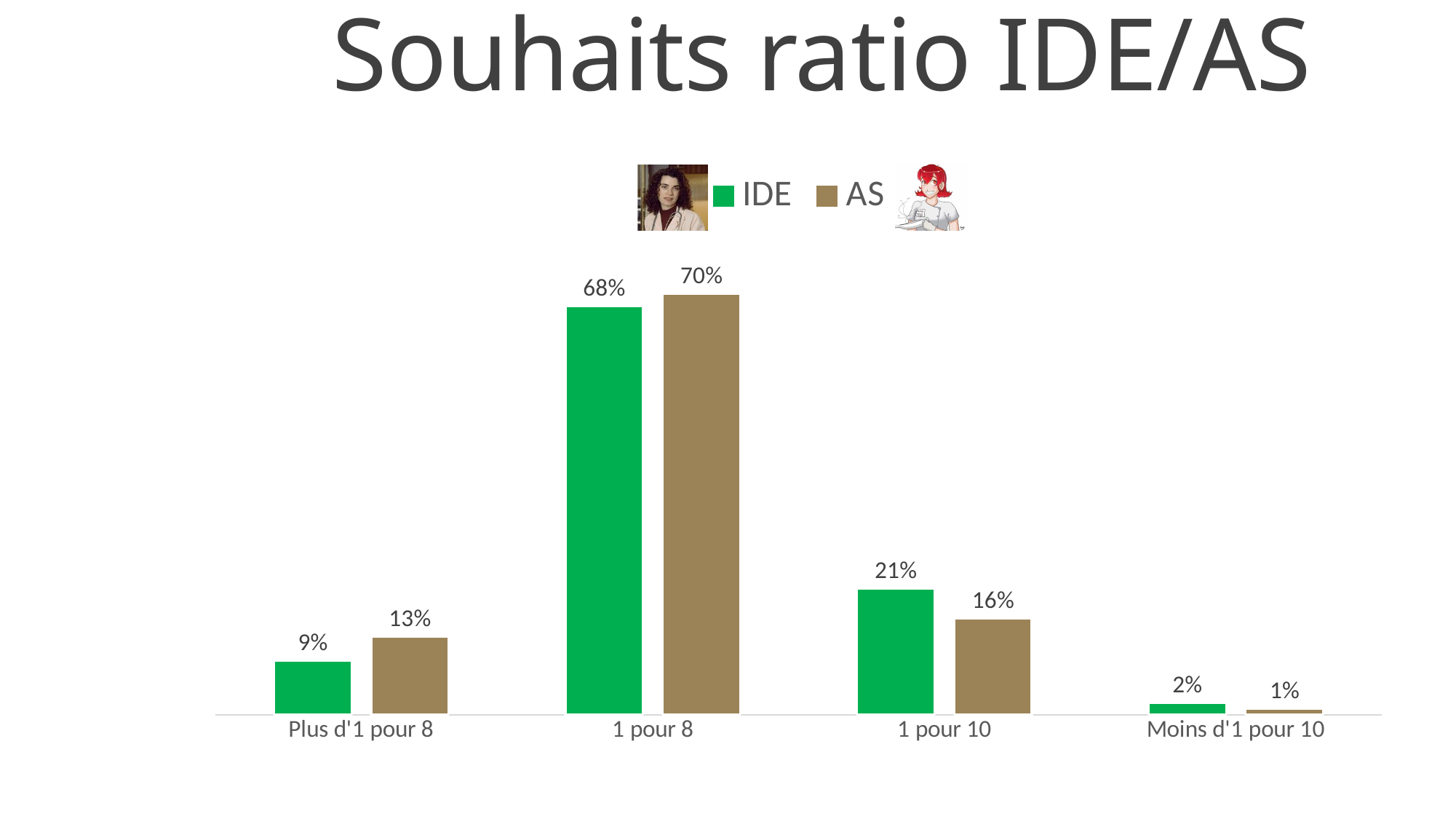
What is the difference between the IDE and AS values for "1 pour 10"? 5% What is the title of the chart? Souhaits ratio IDE/AS What is the IDE value for "Moins d'1 pour 10"? 2% What is the AS value for "1 pour 10"? 16% Which category has the lowest AS value? Moins d'1 pour 10 What kind of chart is shown on the slide? Bar chart For "Plus d'1 pour 8", which series has the larger value, IDE or AS? AS What is the AS value for "Plus d'1 pour 8"? 13% What is the IDE value for "1 pour 8"? 68% How many categories are shown on the x axis? 4 How many series does the legend list? 2 Which category has the highest IDE value? 1 pour 8